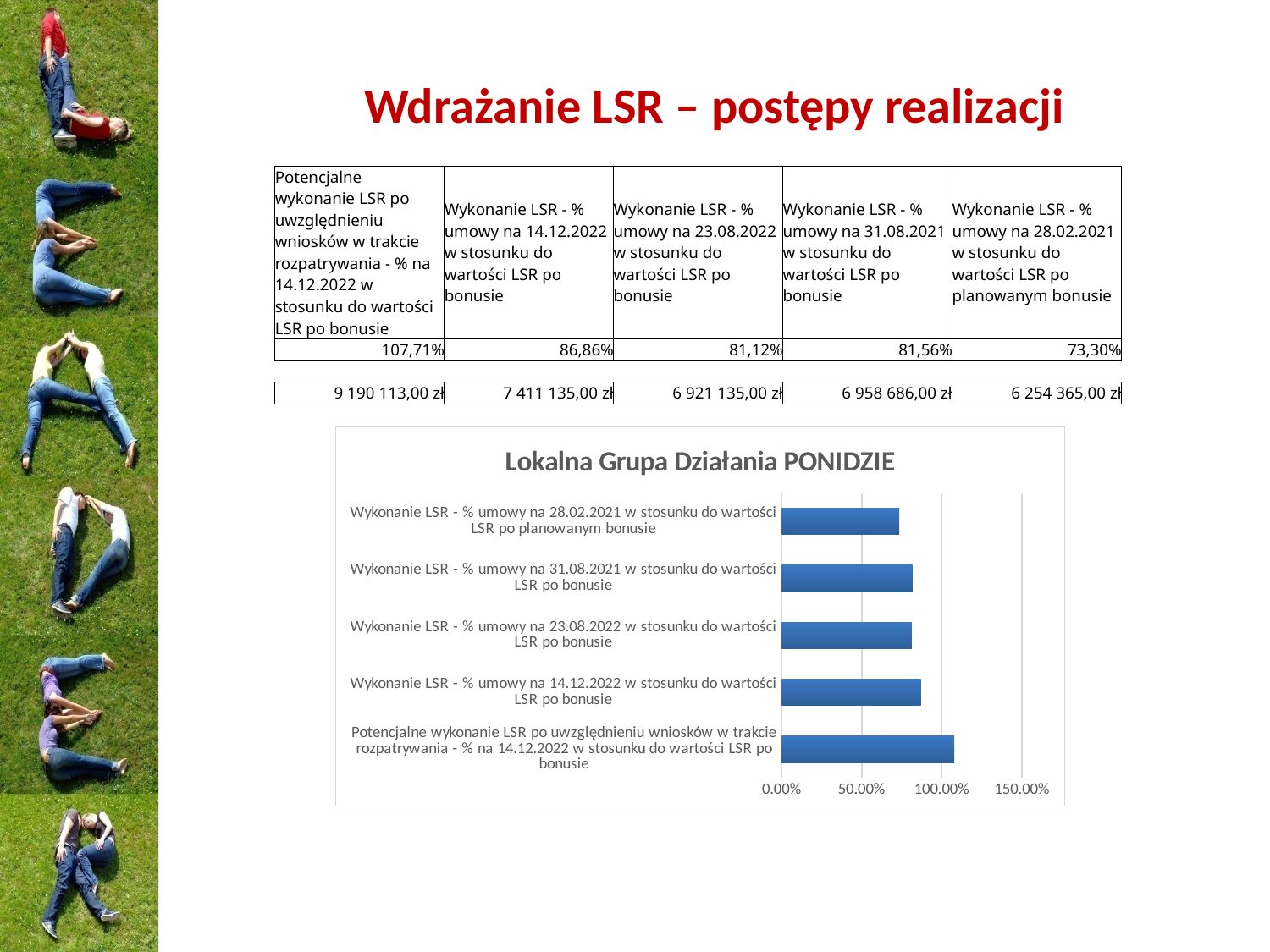
Is the bar for 'Wykonanie LSR - % umowy na 14.12.2022' greater or less than 50.00%? greater What kind of chart is shown on the slide? bar chart Is the bar for 'Wykonanie LSR - % umowy na 28.02.2021' greater or less than 100.00%? less Which bar is longer: 'Wykonanie LSR - % umowy na 14.12.2022' or 'Wykonanie LSR - % umowy na 28.02.2021'? Wykonanie LSR - % umowy na 14.12.2022 Is the bar for 'Potencjalne wykonanie LSR po uwzględnieniu wniosków w trakcie rozpatrywania' greater or less than 100.00%? greater What is the highest value shown on the chart's horizontal axis? 150.00% Which category has the longest bar in the chart? Potencjalne wykonanie LSR po uwzględnieniu wniosków w trakcie rozpatrywania - % na 14.12.2022 w stosunku do wartości LSR po bonusie According to the table above the chart, what is the value for 'Wykonanie LSR - % umowy na 28.02.2021 w stosunku do wartości LSR po planowanym bonusie'? 73,30% Which category has the shortest bar in the chart? Wykonanie LSR - % umowy na 28.02.2021 w stosunku do wartości LSR po planowanym bonusie According to the table above the chart, what is the value for 'Wykonanie LSR - % umowy na 14.12.2022 w stosunku do wartości LSR po bonusie'? 86,86% What is the title of the chart? Lokalna Grupa Działania PONIDZIE How many bars (categories) does the chart show? 5